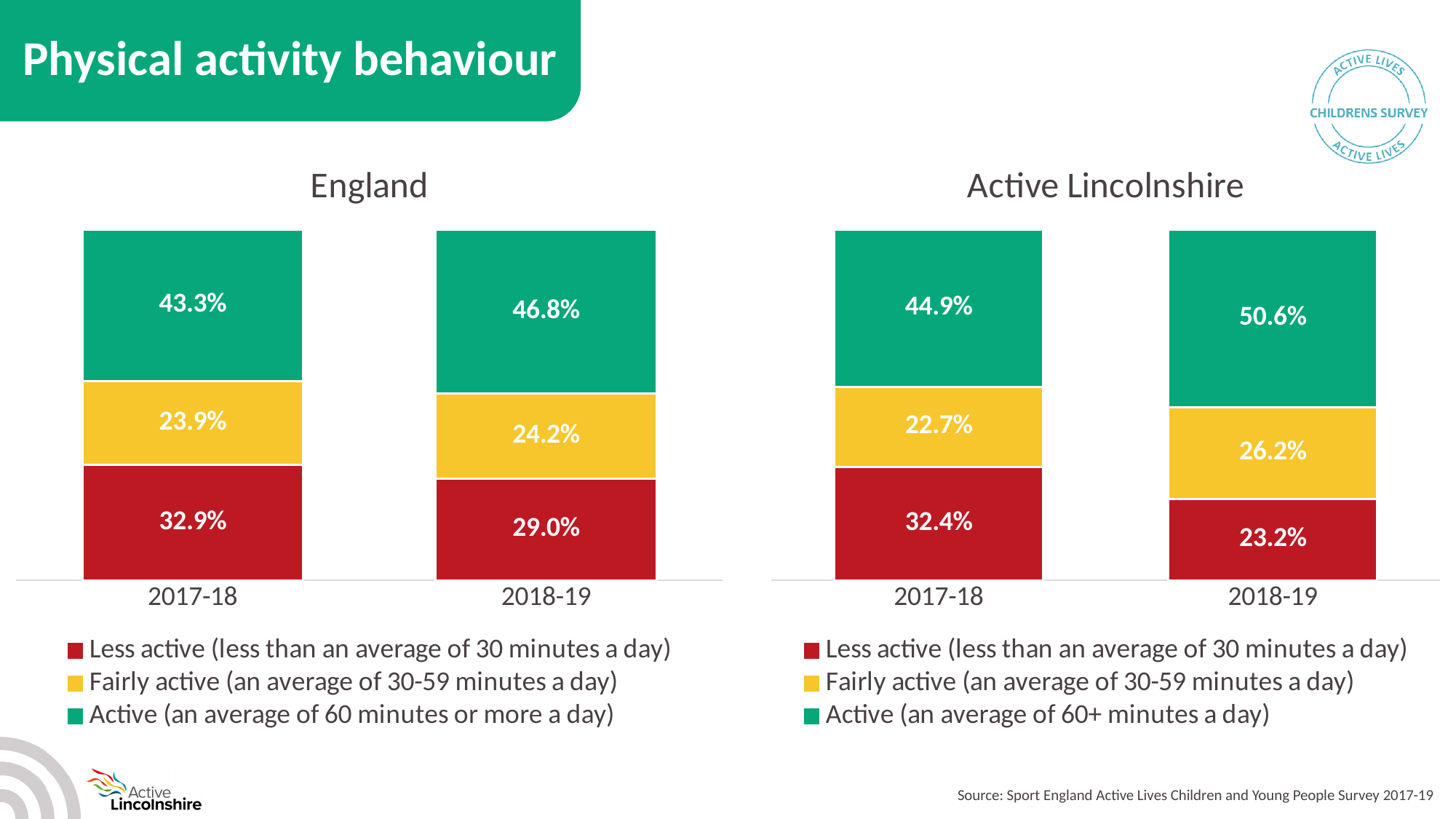
In the England chart, by how many percentage points did the Less active share fall from 2017-18 to 2018-19? 3.9 percentage points In the Active Lincolnshire chart, what percentage of children were Less active in 2018-19? 23.2% Which chart shows the higher Active value for 2018-19, England or Active Lincolnshire? Active Lincolnshire How many series does the legend of the Active Lincolnshire chart list? 3 In the Active Lincolnshire chart, which category has the largest share in 2018-19? Active (an average of 60+ minutes a day) What type of chart is used for the England data? stacked bar chart In the England chart, which category has the smallest share in 2017-18? Fairly active (an average of 30-59 minutes a day) In the Active Lincolnshire chart, what is the Fairly active value for 2017-18? 22.7% In the Active Lincolnshire chart, by how many percentage points did the Active share change from 2017-18 to 2018-19? 5.7 percentage points In the England chart, what percentage of children were Active (an average of 60 minutes or more a day) in 2018-19? 46.8% In the England chart, does the Active share rise or fall from 2017-18 to 2018-19? rise In the England chart, what is the Less active value for 2017-18? 32.9%